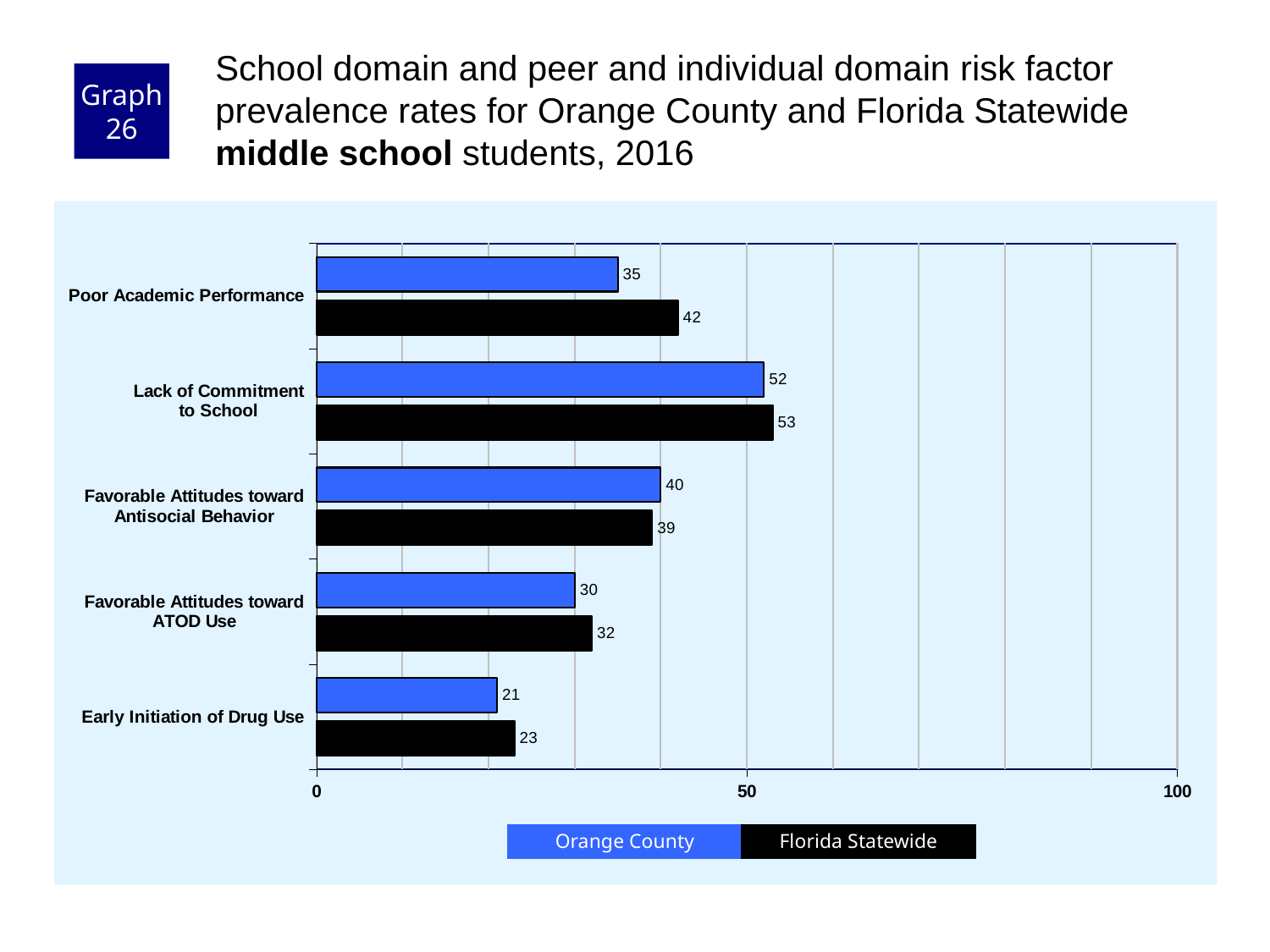
How many risk factor categories are shown on the chart? 5 Which colour represents Florida Statewide in the chart? black Which risk factor has the highest Orange County value? Lack of Commitment to School What is the Orange County value for Poor Academic Performance? 35 What is the difference between the Florida Statewide and Orange County values for Poor Academic Performance? 7 What is the Florida Statewide value for Lack of Commitment to School? 53 How many series does the legend list? 2 Which risk factor has the lowest Florida Statewide value? Early Initiation of Drug Use Is the Florida Statewide value for Lack of Commitment to School greater or less than 50? greater What kind of chart is shown on the slide? bar chart What is the Orange County value for Early Initiation of Drug Use? 21 For Favorable Attitudes toward Antisocial Behavior, which is larger: the Orange County value or the Florida Statewide value? Orange County